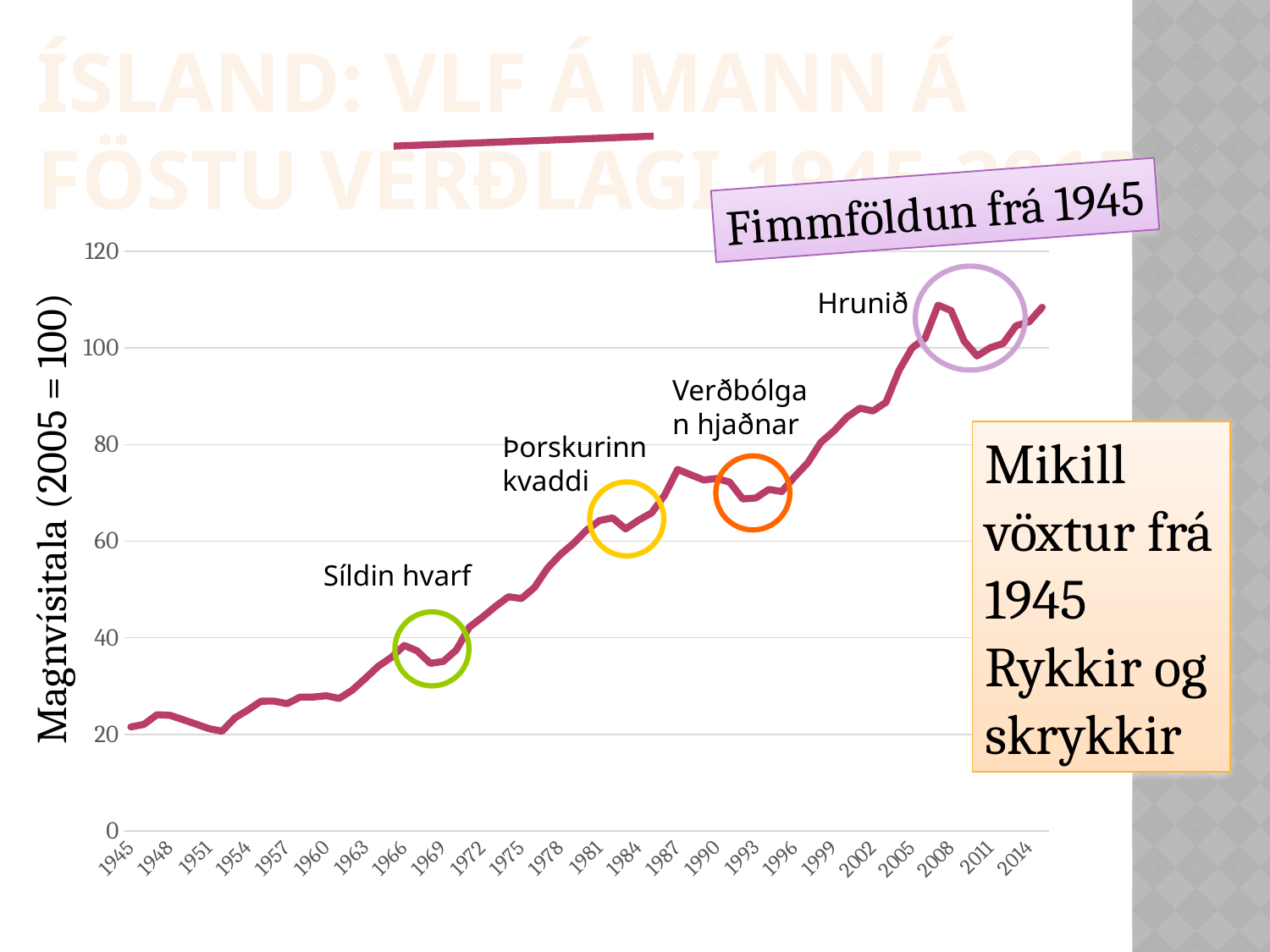
Is the value for 1945 greater or less than 40? less Which annotation labels the circled dip around 2008–2011? Hrunið Which is larger, the value for 1960 or the value for 1990? 1990 Is the value for 1987 greater or less than 60? greater How many lines are plotted on the chart? 1 What is the title of the vertical axis? Magnvísitala (2005 = 100) What kind of chart is shown on the slide? line chart Overall, does the index rise or fall from 1945 to 2014? rise Is the value for 2014 greater or less than 100? greater What is the index value for 2005, according to the axis title? 100